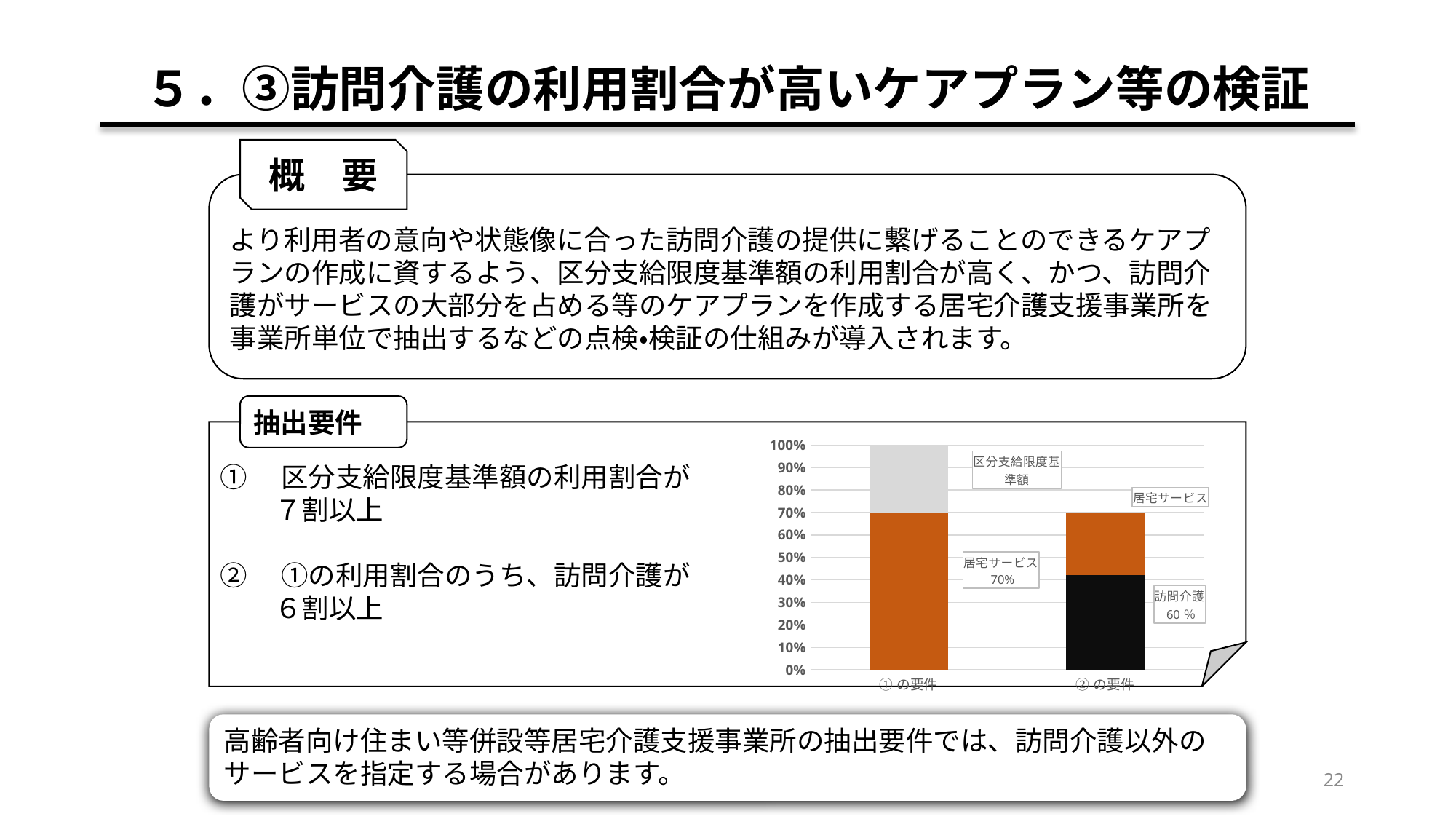
What is the total height of the ①の要件 stacked bar? 100% Which bar is taller, ①の要件 or ②の要件? ①の要件 What percentage is printed in the label for 訪問介護 in the chart? 60 % Which segment is labelled 区分支給限度基準額 in the chart, the grey, orange or black one? grey How many categories are shown on the x axis of the chart? 2 What is the highest value shown on the y axis of the chart? 100% Is the black 訪問介護 segment in the ②の要件 bar greater or less than 30%? greater What are the two category labels on the x axis of the chart? ①の要件, ②の要件 What percentage is printed in the label for 居宅サービス in the chart? 70% Is the black 訪問介護 segment in the ②の要件 bar greater or less than 50%? less What kind of chart is shown on the slide? bar chart What is the total height of the ②の要件 stacked bar? 70%